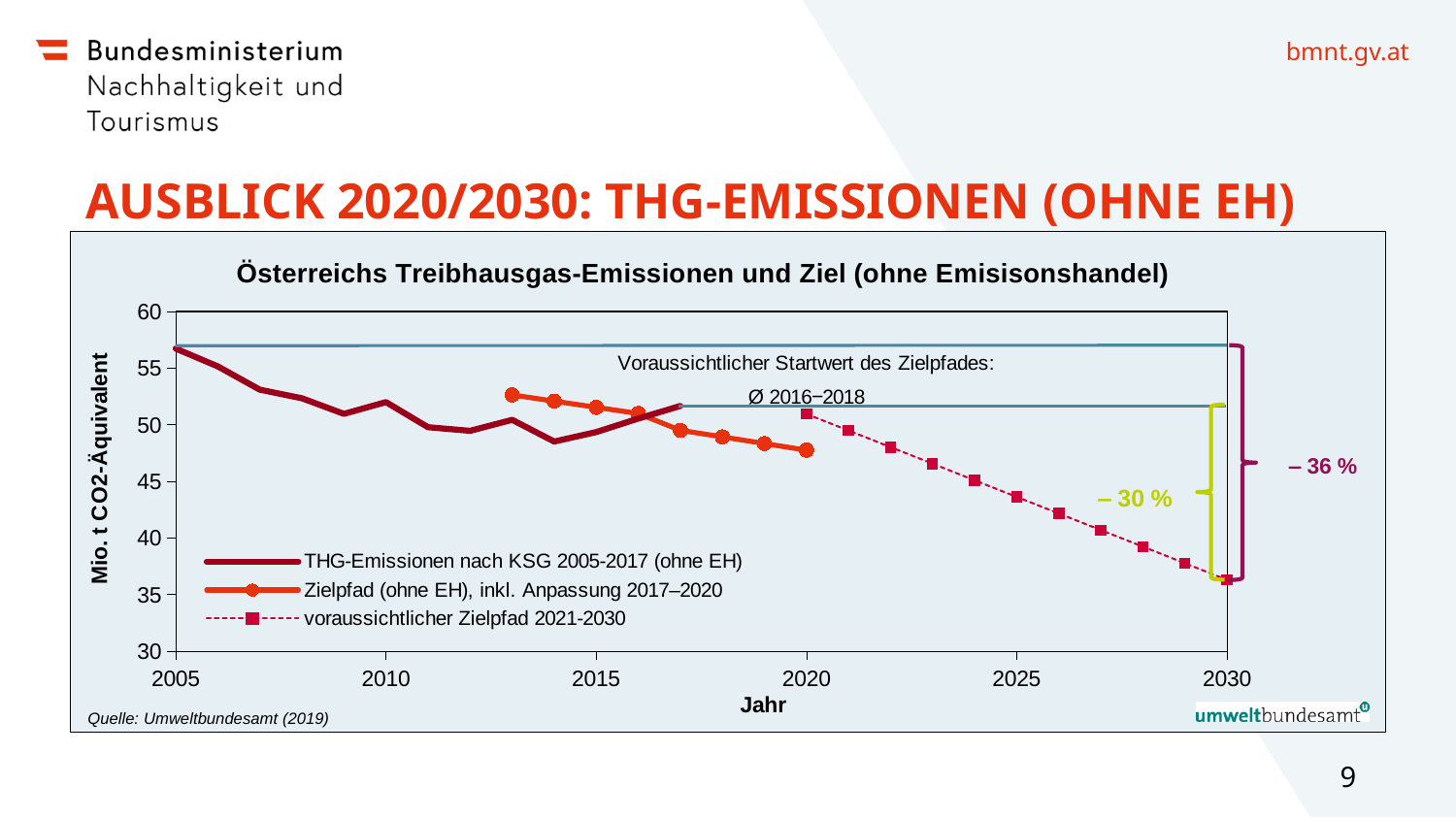
Does the 'voraussichtlicher Zielpfad 2021-2030' series rise or fall from 2021 to 2030? fall What kind of chart is shown on the slide? line chart Is the value of 'THG-Emissionen nach KSG 2005-2017 (ohne EH)' in 2010 greater or less than 50? greater Is the value of 'voraussichtlicher Zielpfad 2021-2030' in 2025 greater or less than 45? less Which is larger for 'Zielpfad (ohne EH), inkl. Anpassung 2017–2020': the value in 2013 or the value in 2020? 2013 What is the title of the chart? Österreichs Treibhausgas-Emissionen und Ziel (ohne Emisisonshandel) Is the value of 'Zielpfad (ohne EH), inkl. Anpassung 2017–2020' in 2020 greater or less than 50? less What percentage reduction is marked by the outer bracket on the right side of the chart, between the 2005 level and the 2030 target? – 36 % How many series does the legend list? 3 Which is larger for 'THG-Emissionen nach KSG 2005-2017 (ohne EH)': the value in 2005 or the value in 2017? 2005 Which year has the lowest value on the 'voraussichtlicher Zielpfad 2021-2030' series? 2030